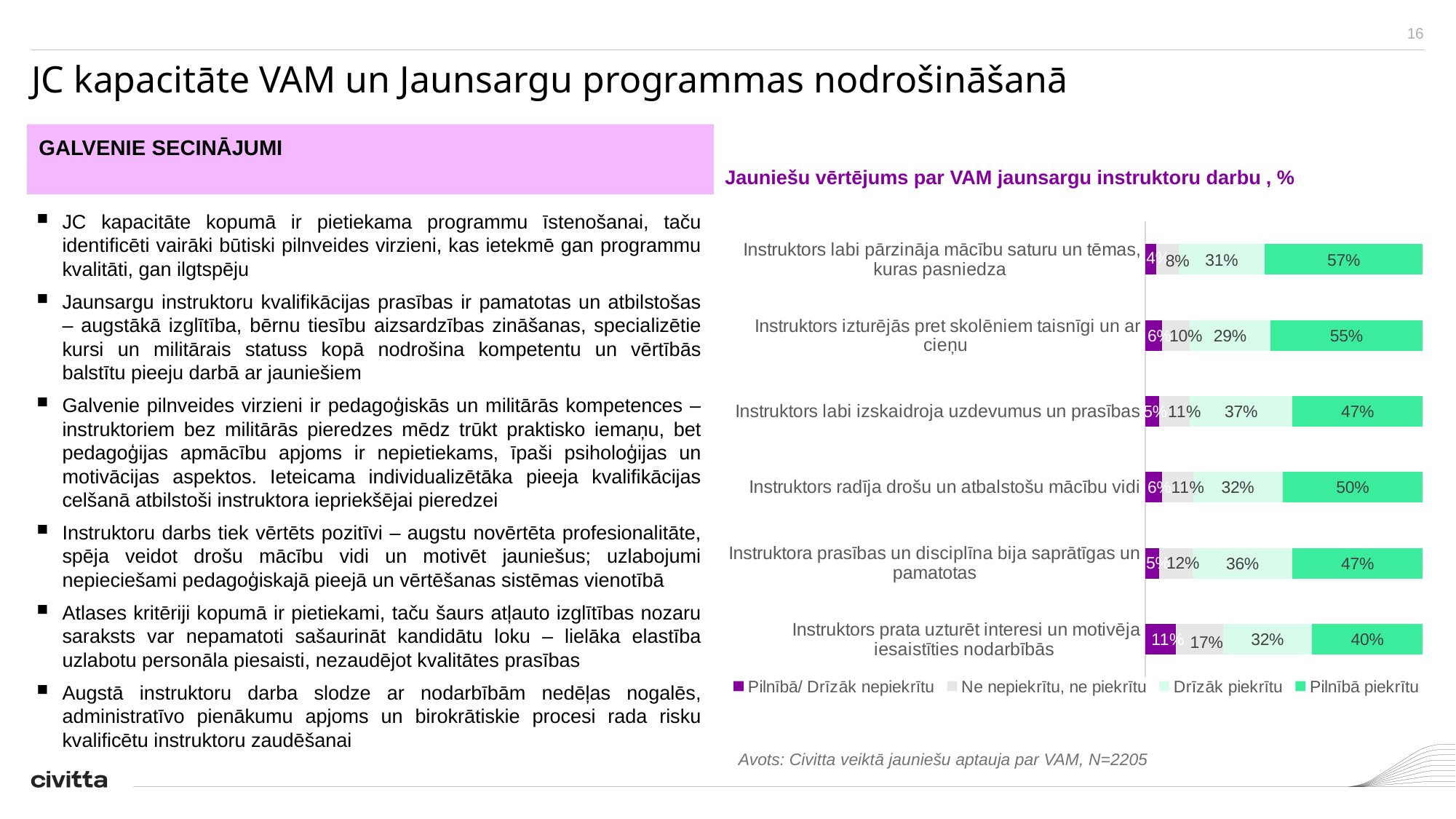
Which statement has the highest 'Pilnībā piekrītu' value? Instruktors labi pārzināja mācību saturu un tēmas, kuras pasniedza What kind of chart is shown on the slide? Stacked bar chart How many series does the legend list? 4 How many statements (categories) are shown in the chart? 6 What is the title of the chart? Jauniešu vērtējums par VAM jaunsargu instruktoru darbu , % What is the 'Drīzāk piekrītu' value for 'Instruktors labi izskaidroja uzdevumus un prasības'? 37% Which is larger: the 'Drīzāk piekrītu' value for 'Instruktora prasības un disciplīna bija saprātīgas un pamatotas' or for 'Instruktors radīja drošu un atbalstošu mācību vidi'? Instruktora prasības un disciplīna bija saprātīgas un pamatotas What is the 'Pilnībā/ Drīzāk nepiekrītu' value for 'Instruktors radīja drošu un atbalstošu mācību vidi'? 6% Which statement has the lowest 'Pilnībā piekrītu' value? Instruktors prata uzturēt interesi un motivēja iesaistīties nodarbībās What is the difference between the 'Pilnībā piekrītu' values for 'Instruktors izturējās pret skolēniem taisnīgi un ar cieņu' and 'Instruktors prata uzturēt interesi un motivēja iesaistīties nodarbībās'? 15% What is the 'Pilnībā piekrītu' value for 'Instruktors labi pārzināja mācību saturu un tēmas, kuras pasniedza'? 57%